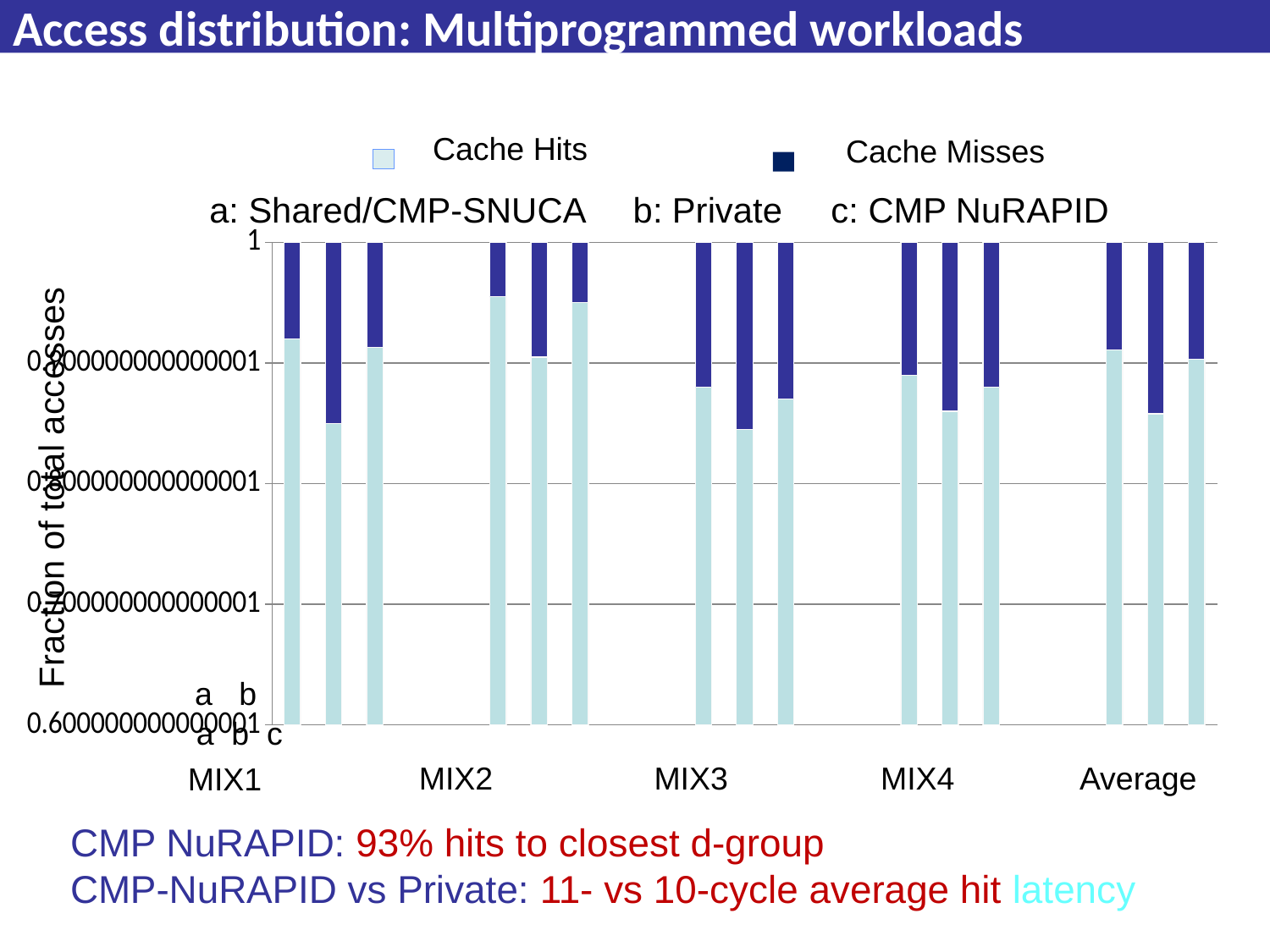
How many series does the legend list? 2 In MIX1, which has the larger Cache Hits fraction: the Shared/CMP-SNUCA (a) bar or the Private (b) bar? Shared/CMP-SNUCA (a) Which configuration does the bar labelled 'c' represent? CMP NuRAPID How many workload categories are shown along the x axis? 5 What are the two series named in the legend? Cache Hits and Cache Misses Is the Cache Hits fraction for the Private (b) bar in MIX3 greater or less than 0.9? less Is the Cache Hits fraction for the Private (b) bar in Average greater or less than 0.9? less How many bars are plotted in total on the chart? 15 Among the Private (b) bars, which workload has the highest Cache Hits fraction? MIX2 Is the Cache Hits fraction for the Private (b) bar in MIX1 greater or less than 0.9? less What kind of chart is shown on the slide? Stacked bar chart